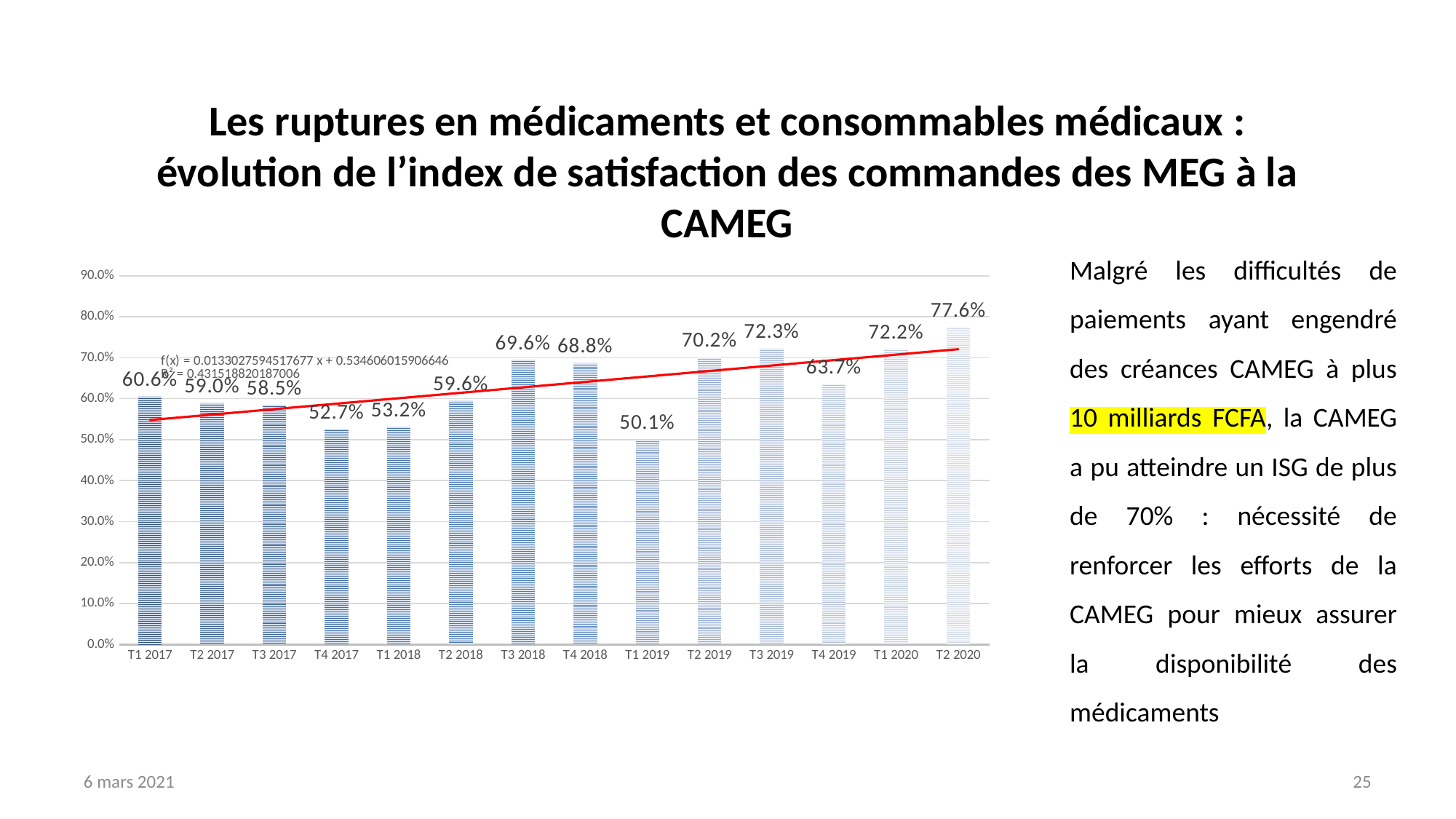
Which quarter has the highest value? T2 2020 What is the difference between the values for T2 2020 and T1 2019? 27.5% What is the value for T2 2020? 77.6% Does the red trend line rise or fall from left to right? rise How many quarters are shown on the x axis? 14 Is the value for T3 2019 greater or less than 70.0%? greater What is the value for T4 2017? 52.7% What is the difference between the values for T1 2017 and T2 2017? 1.6% What is the value for T1 2019? 50.1% Which is larger, the value for T3 2018 or the value for T4 2018? T3 2018 What kind of chart is shown on the slide? bar chart Which quarter has the lowest value? T1 2019